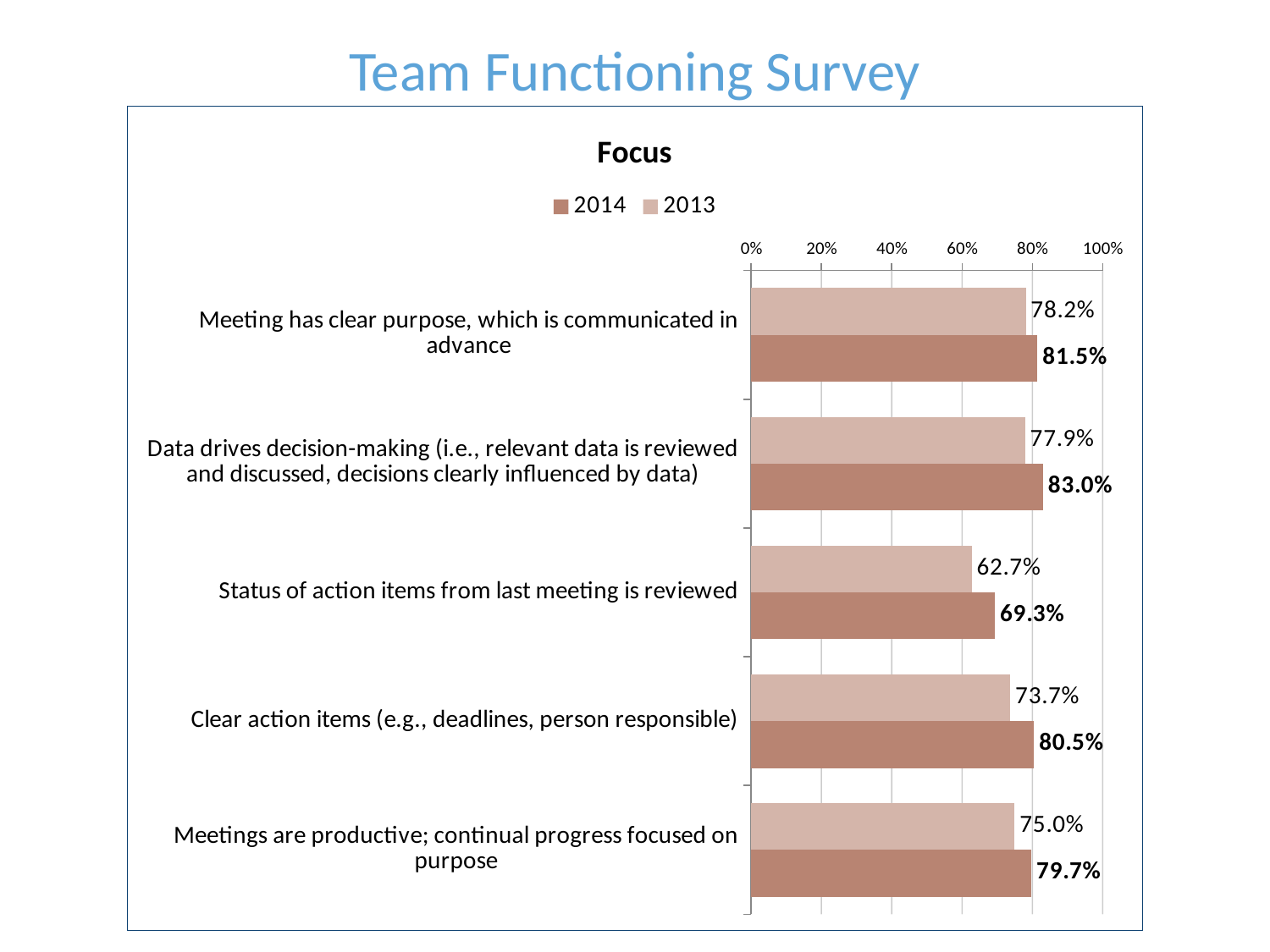
How many categories are shown in the chart? 5 Which category has the highest 2014 value? Data drives decision-making (i.e., relevant data is reviewed and discussed, decisions clearly influenced by data) What is the title of the chart? Focus What is the difference between the 2014 and 2013 values for "Clear action items (e.g., deadlines, person responsible)"? 6.8% How many series does the legend list? 2 Which is larger for "Meetings are productive; continual progress focused on purpose": the 2014 value or the 2013 value? 2014 What is the 2013 value for "Clear action items (e.g., deadlines, person responsible)"? 73.7% What kind of chart is shown on the slide? bar chart Which category has the lowest 2013 value? Status of action items from last meeting is reviewed What is the 2014 value for "Status of action items from last meeting is reviewed"? 69.3% Is the 2013 value for "Status of action items from last meeting is reviewed" greater or less than 80%? less What is the 2014 value for "Data drives decision-making"? 83.0%